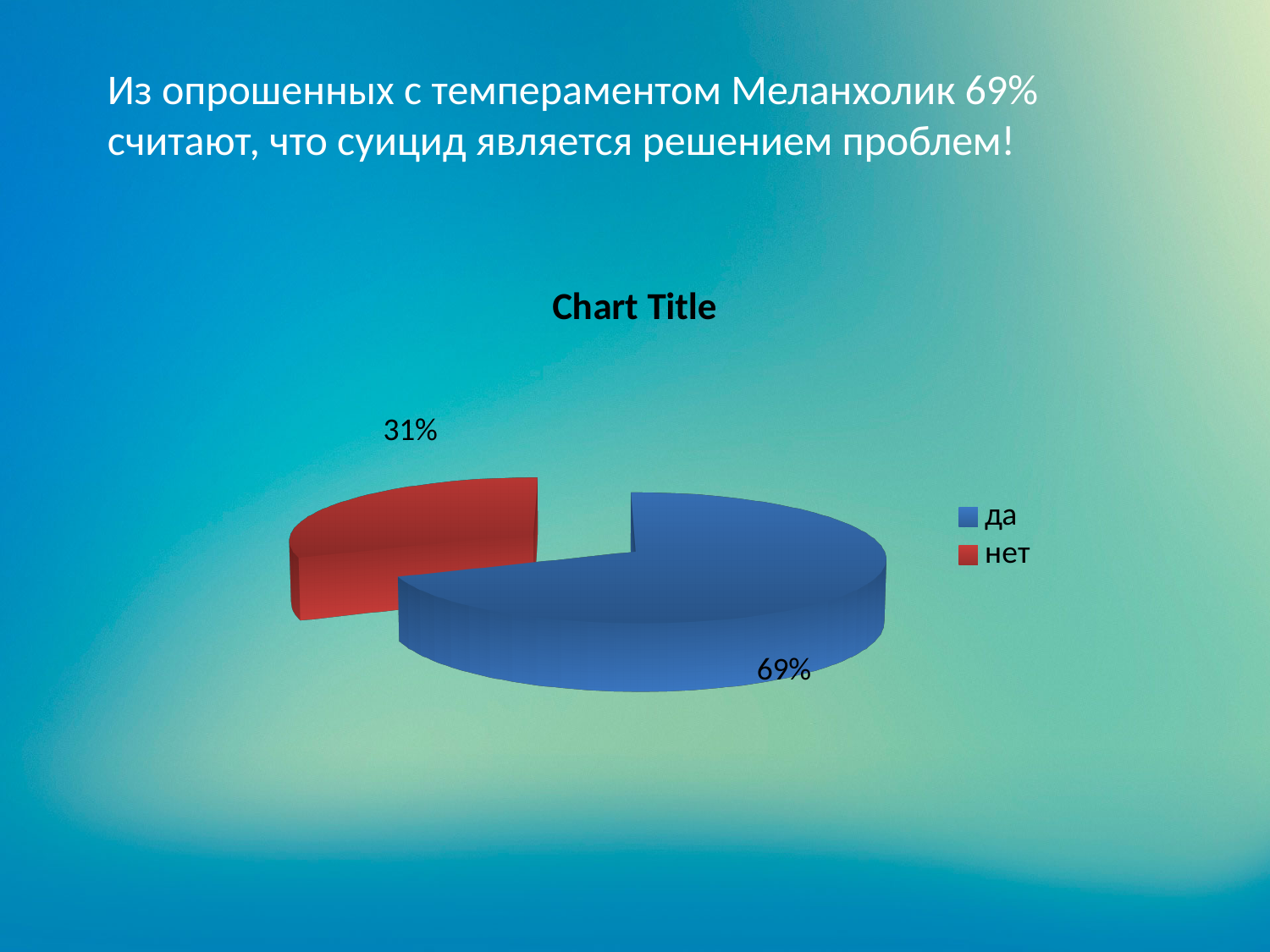
What is the difference between the "да" and "нет" slices? 38% What share of the pie does the "нет" slice represent? 31% What is the title of the chart? Chart Title Which is larger, the "да" slice or the "нет" slice? да Which slice is the smallest? нет What is the value for the "да" slice? 69% How many entries does the legend list? 2 How many slices does the pie chart have? 2 What kind of chart is shown on the slide? pie chart What colour is the "нет" slice? red What is the value for the "нет" slice? 31% Which slice is the largest? да